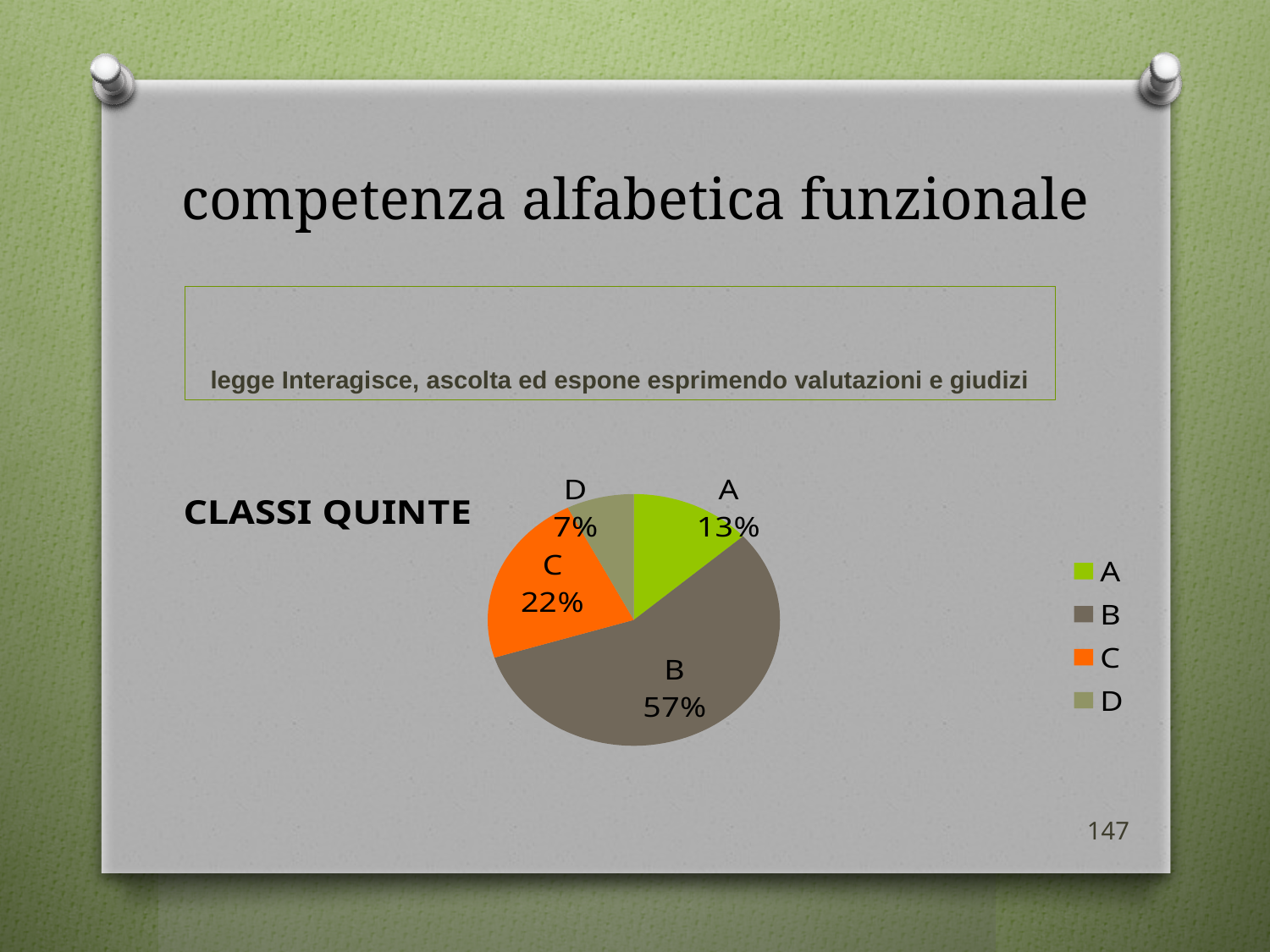
What kind of chart is shown on the slide? Pie chart How many categories are shown in the pie chart? 4 What is the difference in percentage points between category A and category D? 6 Which category has the smallest slice of the pie? D Which category has the largest slice of the pie? B What colour is the slice for category C? Orange What share of the pie does category A represent? 13% Which is larger, the slice for A or the slice for C? C What share of the pie does category D represent? 7% What is the difference in percentage points between category B and category C? 35 What share of the pie does category B represent? 57% What share of the pie does category C represent? 22%